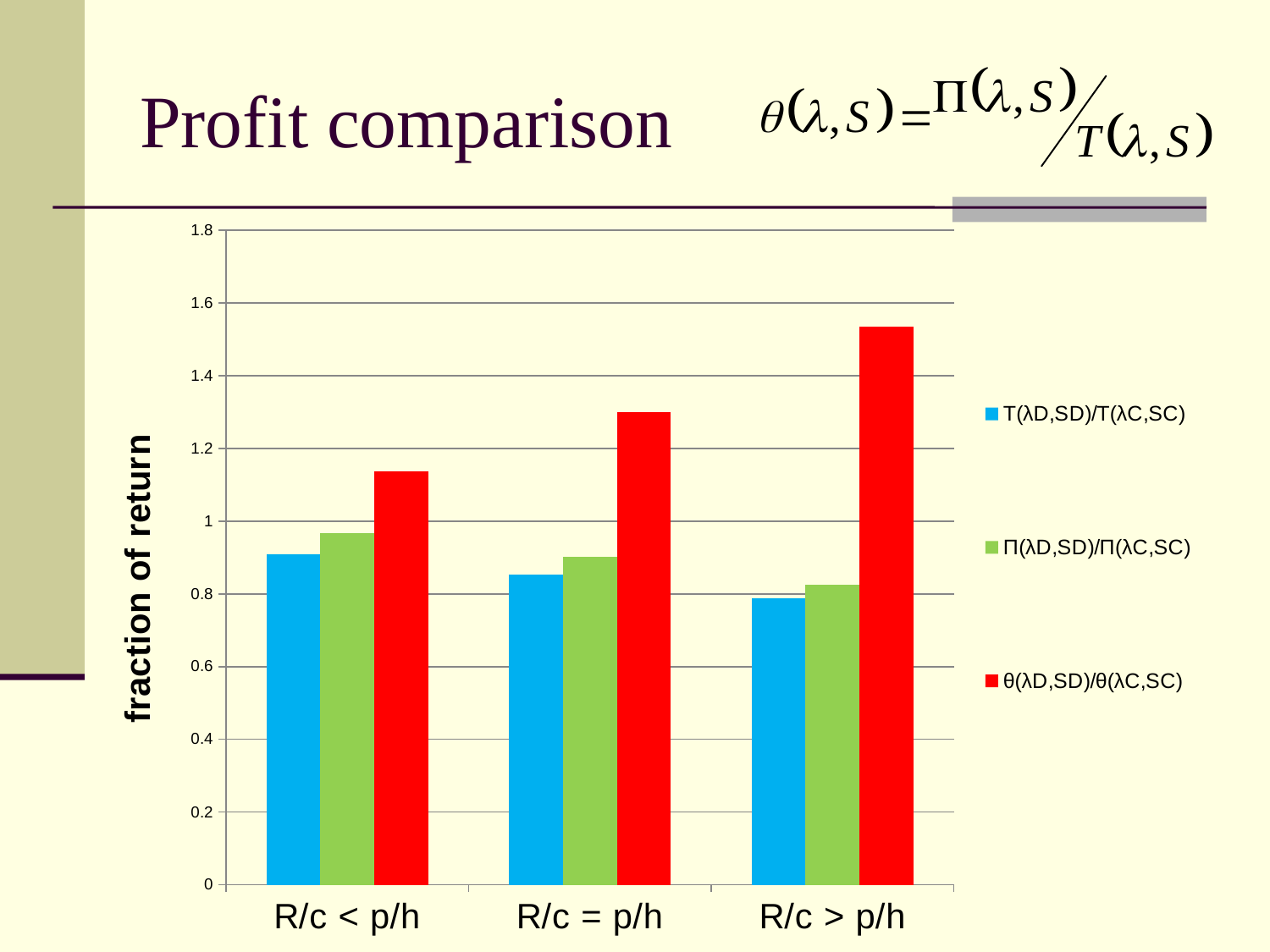
In which category is the θ(λD,SD)/θ(λC,SC) series highest? R/c > p/h For R/c = p/h, which is larger: θ(λD,SD)/θ(λC,SC) or Π(λD,SD)/Π(λC,SC)? θ(λD,SD)/θ(λC,SC) How many categories are shown on the x axis of the chart? 3 What kind of chart is shown on the slide? bar chart Is the value of T(λD,SD)/T(λC,SC) for R/c < p/h greater or less than 1? less What is the title of the vertical axis? fraction of return How many series does the chart's legend list? 3 In which category is the T(λD,SD)/T(λC,SC) series lowest? R/c > p/h Which series is drawn in red? θ(λD,SD)/θ(λC,SC) Is the value of θ(λD,SD)/θ(λC,SC) for R/c > p/h greater or less than 1.4? greater Does the T(λD,SD)/T(λC,SC) series rise or fall from R/c < p/h to R/c > p/h? fall Does the θ(λD,SD)/θ(λC,SC) series rise or fall from R/c < p/h to R/c > p/h? rise